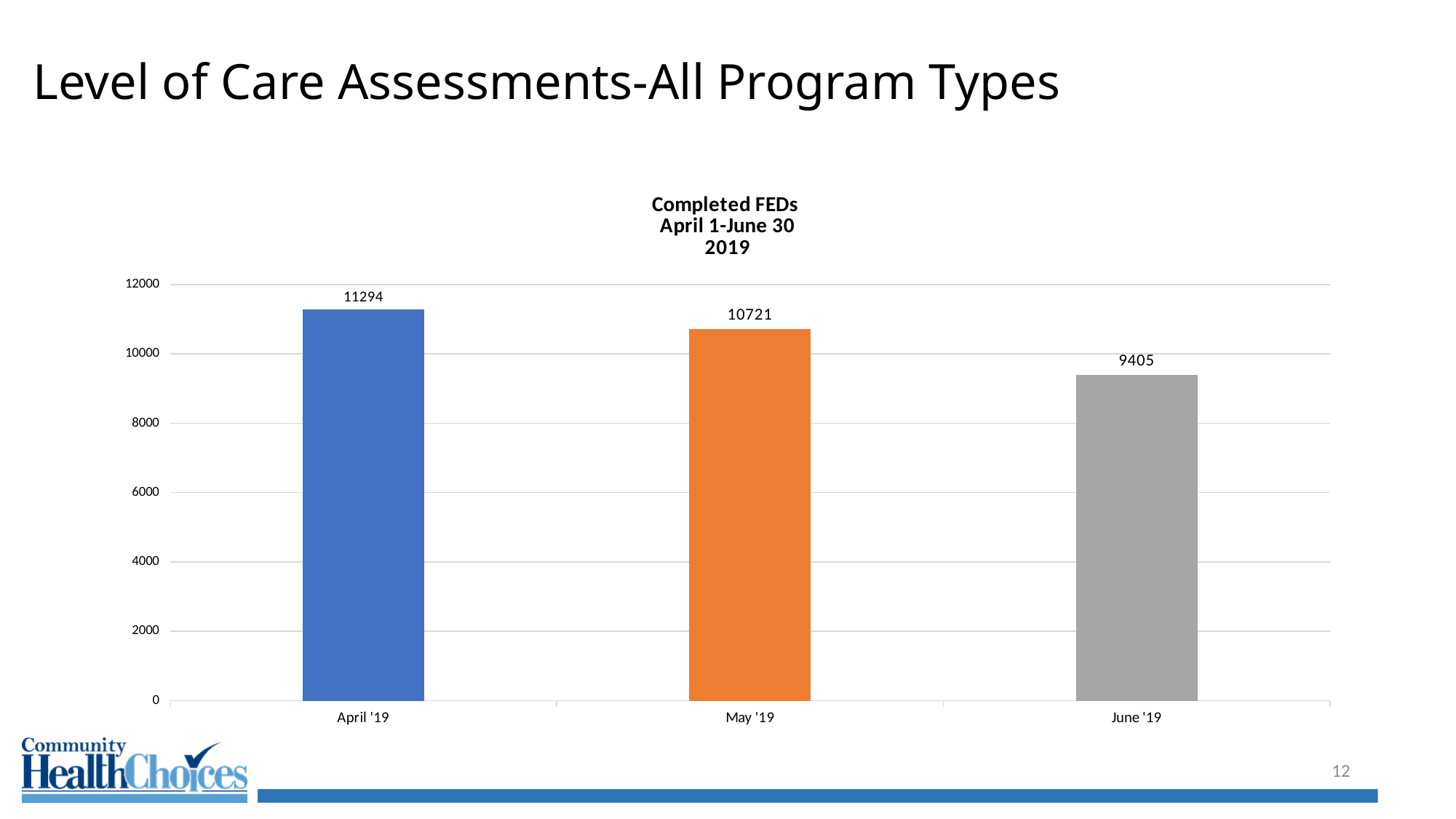
Do the values rise or fall from April '19 to June '19? fall What is the difference between the values for April '19 and June '19? 1889 How many months are shown on the chart? 3 What kind of chart is shown on the slide? bar chart Is the value for June '19 greater or less than 10000? less What is the value for April '19? 11294 Which is larger, the value for May '19 or the value for June '19? May '19 Which month has the lowest number of completed FEDs? June '19 What is the difference between the values for April '19 and May '19? 573 Which month has the highest number of completed FEDs? April '19 What is the value for May '19? 10721 What is the value for June '19? 9405